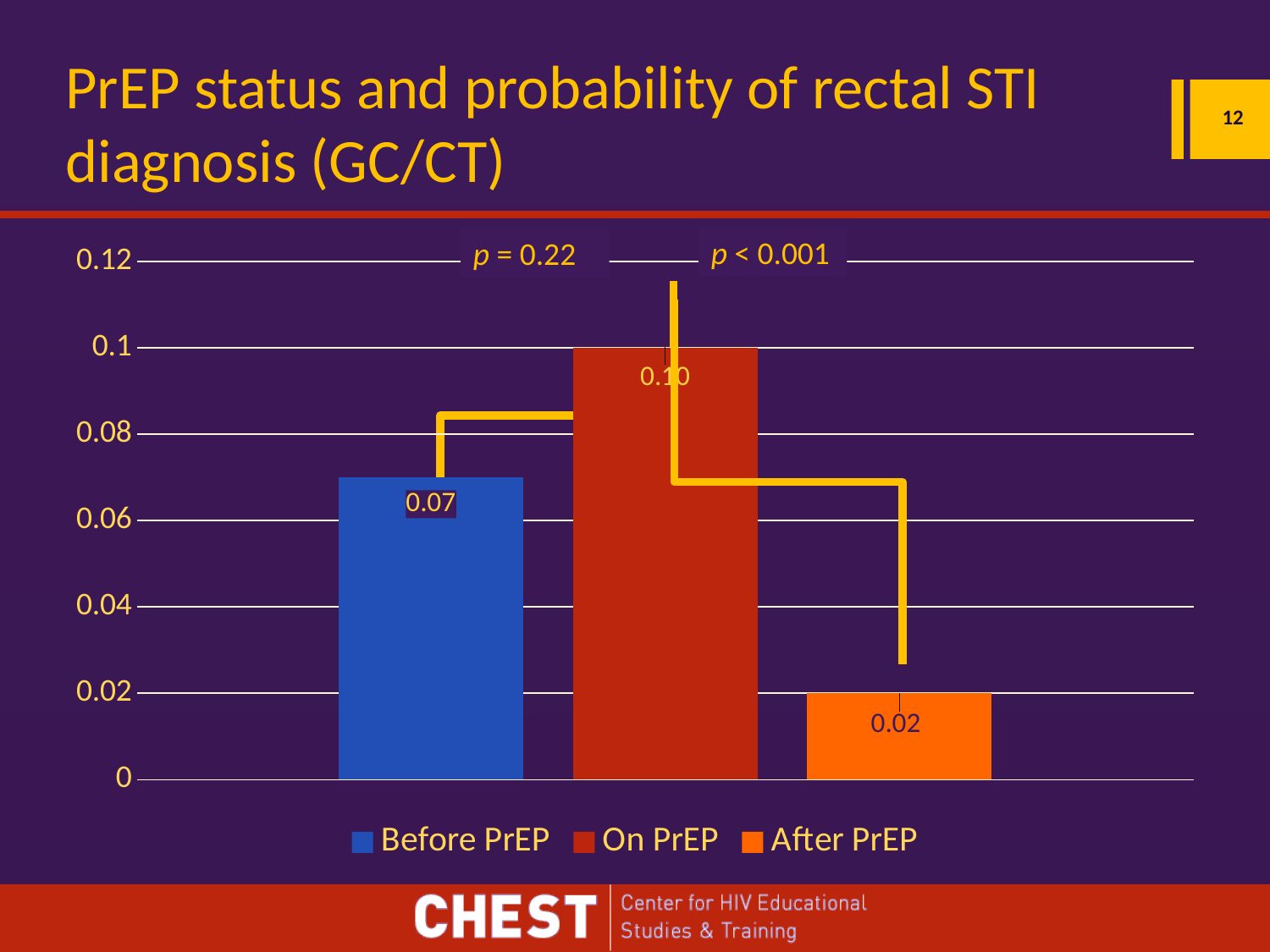
What is the probability of rectal STI diagnosis for the After PrEP group? 0.02 What is the probability of rectal STI diagnosis for the On PrEP group? 0.10 What kind of chart is shown on the slide? Bar chart Which is larger, the probability for Before PrEP or for After PrEP? Before PrEP What is the difference in probability between the On PrEP and Before PrEP groups? 0.03 What p-value is shown for the comparison between On PrEP and After PrEP? p < 0.001 Which group has the lowest probability of rectal STI diagnosis? After PrEP How many groups are shown in the chart? 3 What is the probability of rectal STI diagnosis for the Before PrEP group? 0.07 Which group has the highest probability of rectal STI diagnosis? On PrEP Is the value for On PrEP greater or less than 0.08? greater What is the difference in probability between the On PrEP and After PrEP groups? 0.08